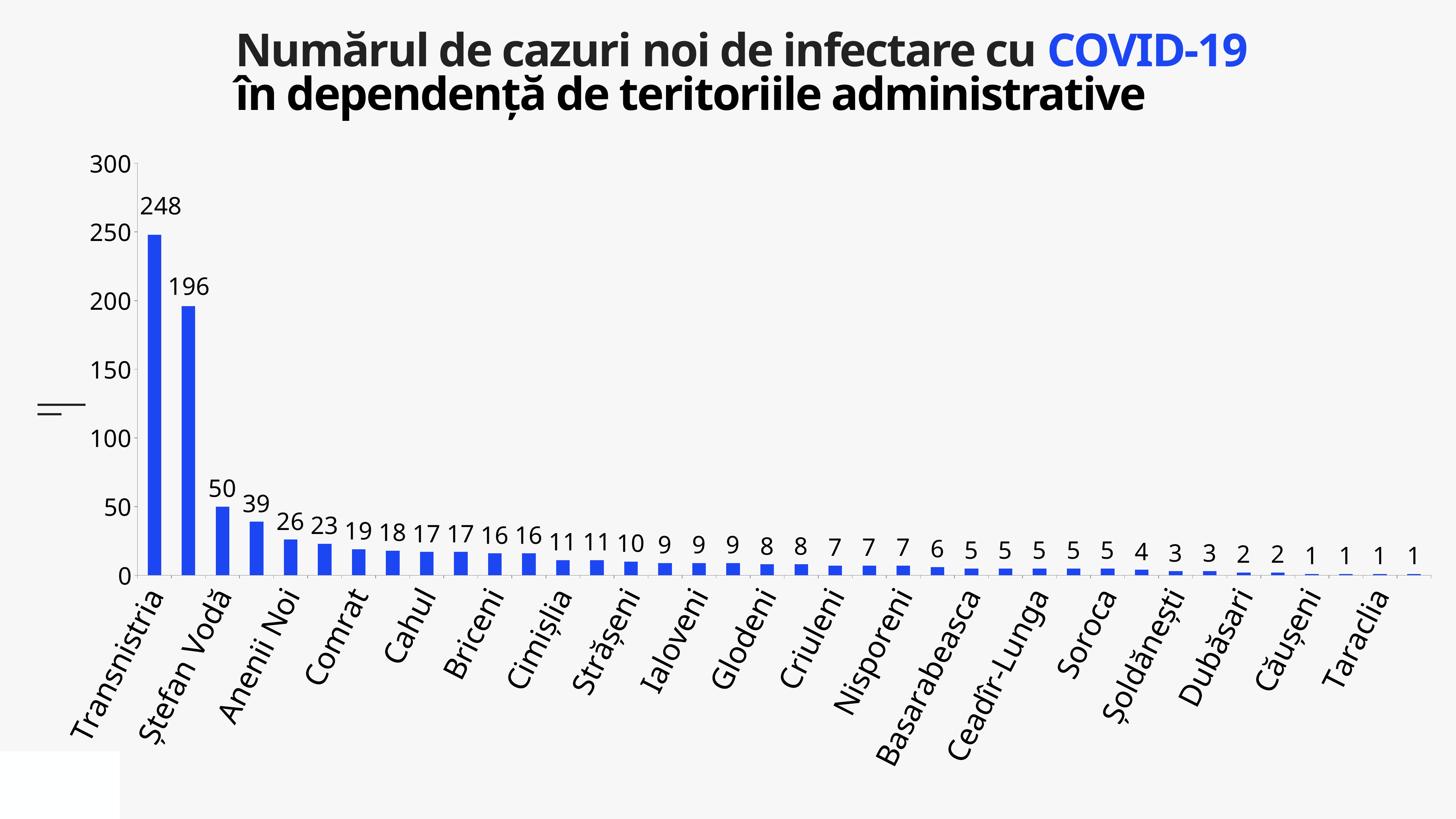
Is the value for Anenii Noi greater or less than 100? less How many new cases are shown for Transnistria? 248 Which territory has the highest number of new COVID-19 cases? Transnistria What is the lowest value shown on any bar in the chart? 1 How many new cases are shown for Soroca? 5 Which has more new cases, Transnistria or Ștefan Vodă? Transnistria How many new cases are shown for Cimișlia? 11 How many new cases are shown for Briceni? 16 Do the values rise or fall from left to right along the x axis? fall What type of chart is shown on the slide? bar chart What is the difference between the two tallest bars (248 and 196)? 52 How many new cases are shown for Criuleni? 7